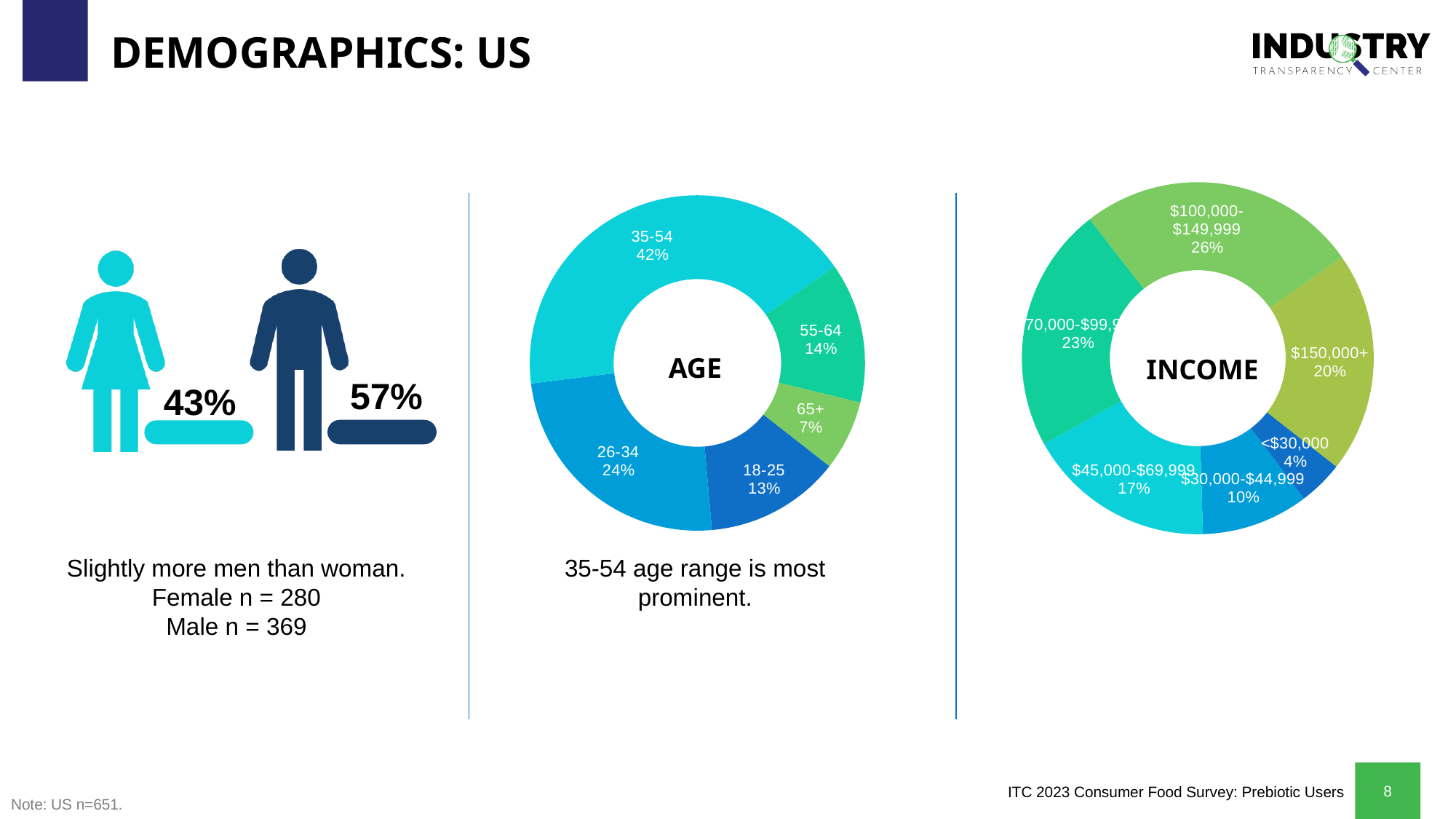
In the INCOME chart, what is the difference in percentage points between the $45,000-$69,999 and $30,000-$44,999 brackets? 7 In the AGE chart, which group has a larger share, 18-25 or 55-64? 55-64 In the AGE chart, which age group has the largest share? 35-54 In the INCOME chart, what percentage of respondents earn $150,000+? 20% What type of chart is the INCOME chart? Donut (pie) chart In the INCOME chart, which income bracket has the largest share? $100,000-$149,999 In the AGE chart, what is the difference in percentage points between the 35-54 and 55-64 groups? 28 How many age groups are shown in the AGE chart? 5 In the AGE chart, what percentage of respondents are aged 26-34? 24% In the AGE chart, which age group has the smallest share? 65+ In the INCOME chart, which income bracket has the smallest share? <$30,000 In the AGE chart, what percentage of respondents are aged 35-54? 42%